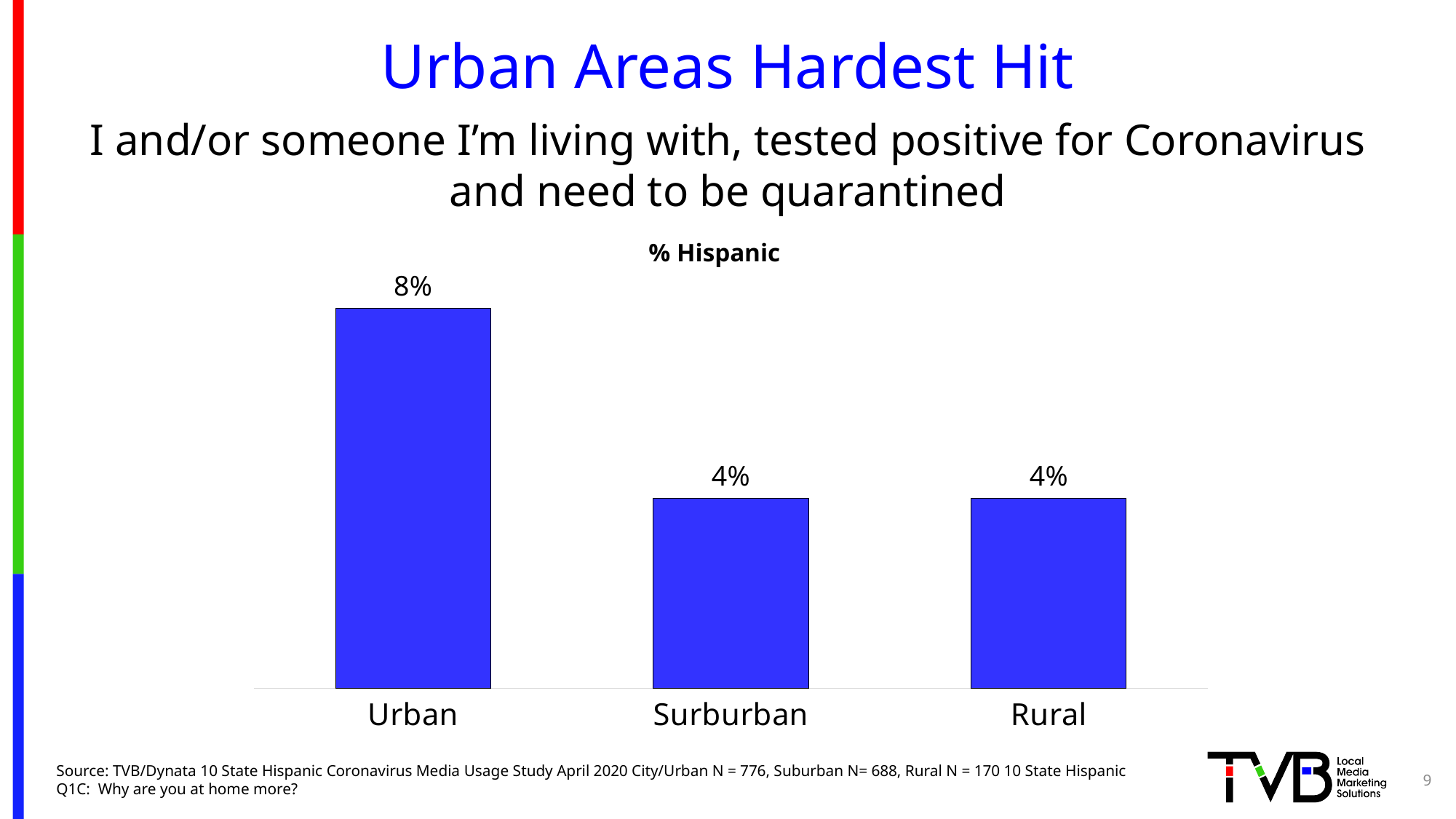
What is the value for Rural? 4% What is the difference between the Urban and Rural values? 4% What colour are the bars in the chart? blue What is the title shown above the chart? % Hispanic How many categories are shown on the x axis? 3 What is the value for Urban? 8% What kind of chart is shown on the slide? bar chart Which is larger, the value for Urban or the value for Surburban? Urban Are the values for Surburban and Rural equal? yes Do the values rise or fall from Urban to Surburban? fall Which category has the highest value? Urban What is the value for Surburban? 4%